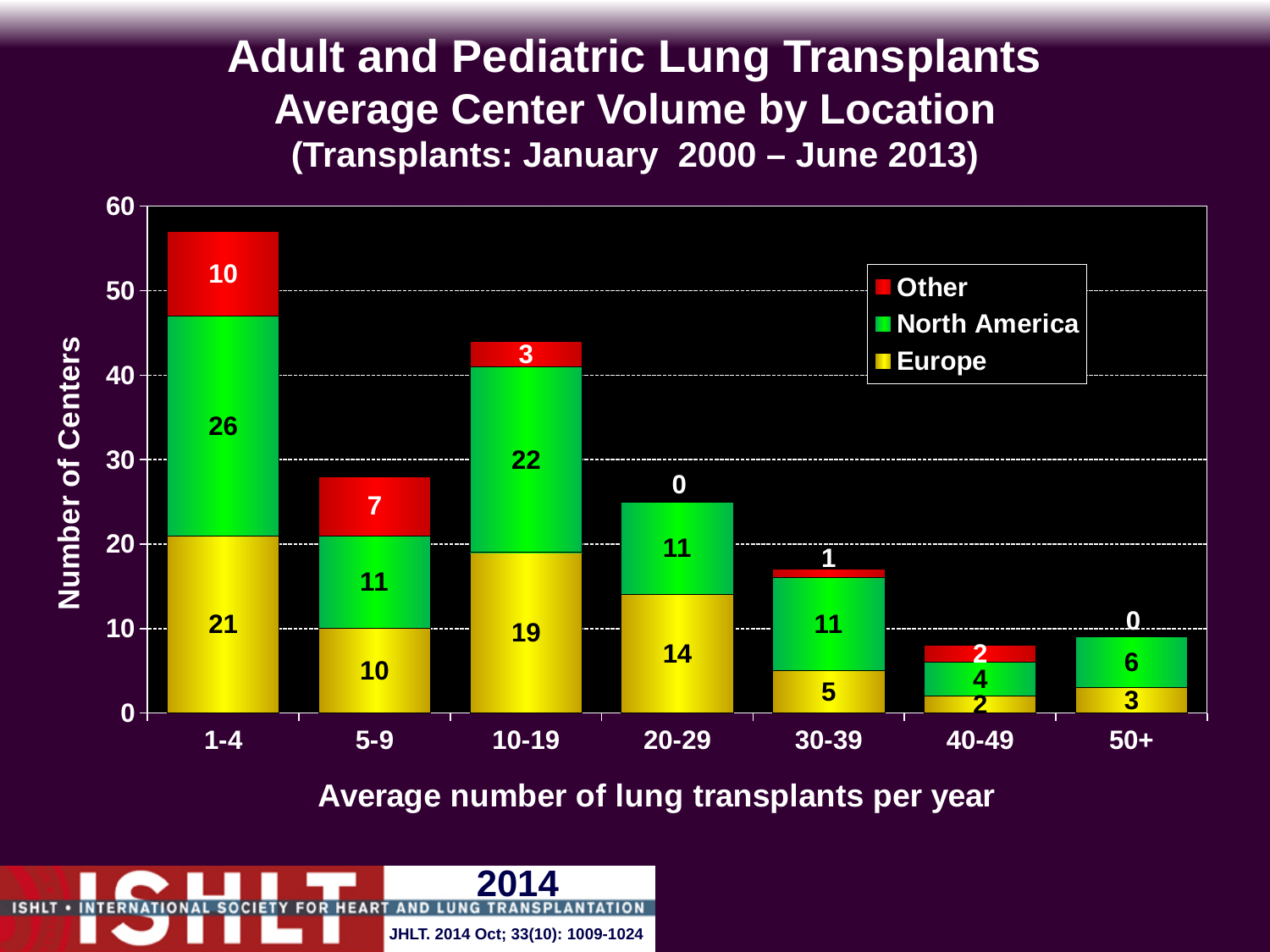
What is the total number of centers in the 1-4 category? 57 How many series does the legend list? 3 What is the number of Europe centers in the 1-4 category? 21 What is the total number of centers in the 30-39 category? 17 What is the difference between the North America and Europe values in the 20-29 category? 3 What is the number of North America centers in the 10-19 category? 22 What is the number of Other centers in the 5-9 category? 7 What type of chart is shown on the slide? Stacked bar chart Which category has the lowest total number of centers? 40-49 Which category has the highest total number of centers? 1-4 How many categories are shown on the x axis? 7 Which is larger in the 50+ category, the Europe value or the North America value? North America